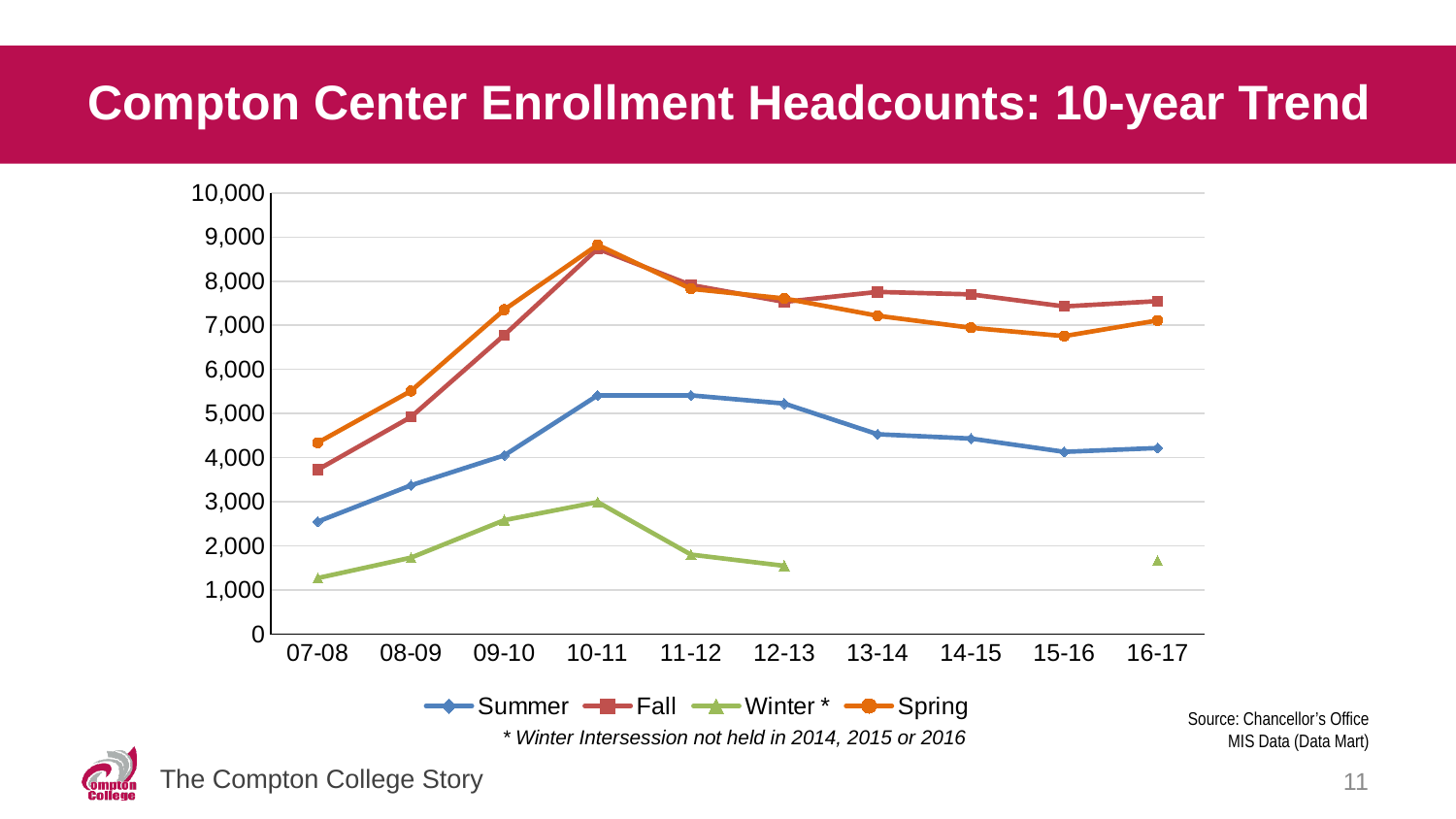
According to the footnote, in which years was the Winter Intersession not held? 2014, 2015 or 2016 Does the Summer headcount rise or fall from 07-08 to 10-11? rise In 16-17, which series has the larger headcount, Fall or Summer? Fall In which academic year does the Fall series reach its highest headcount? 10-11 Is the Spring headcount in 10-11 greater or less than 8,000? greater Is the Winter headcount in 10-11 greater or less than 2,000? greater In which academic year does the Winter series reach its highest value? 10-11 Is the Summer headcount in 07-08 greater or less than 3,000? less What kind of chart is shown on the slide? line chart How many series does the legend list? 4 In which academic year is the Summer headcount lowest? 07-08 How many academic years are shown along the x axis? 10